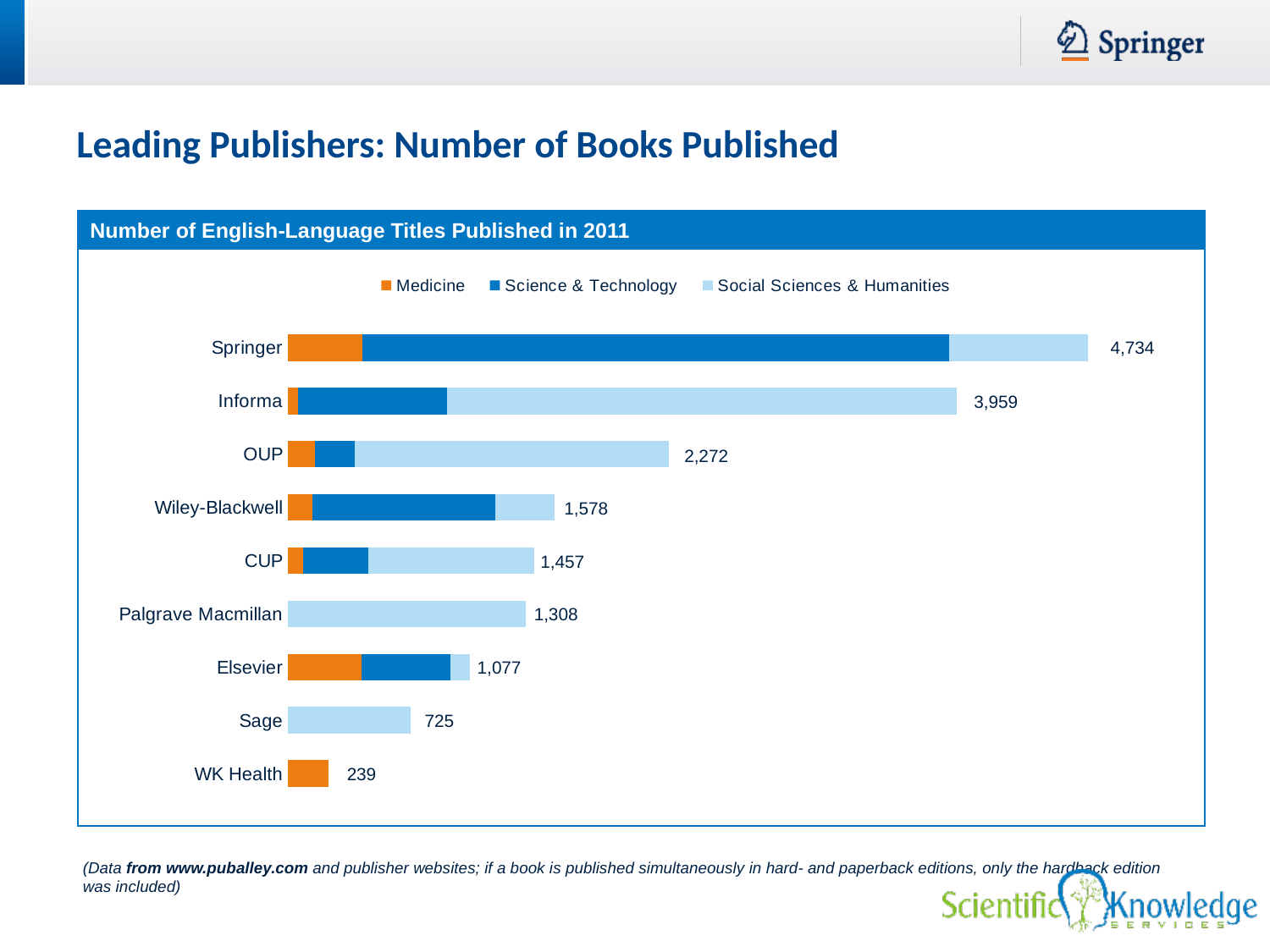
What is the difference between the total titles for OUP and Sage? 1,547 What is the total number of titles shown for Palgrave Macmillan? 1,308 Which publisher has a larger total, Wiley-Blackwell or CUP? Wiley-Blackwell What kind of chart is shown on the slide? Stacked bar chart What is the total number of titles shown for WK Health? 239 What is the total number of titles shown for Informa? 3,959 How many publishers are shown in the chart? 9 Which publisher has the lowest total number of titles published? WK Health What is the total number of English-language titles published in 2011 by Springer? 4,734 Which publisher has the highest total number of titles published? Springer What is the difference between the total titles for Springer and Informa? 775 How many series does the legend list? 3